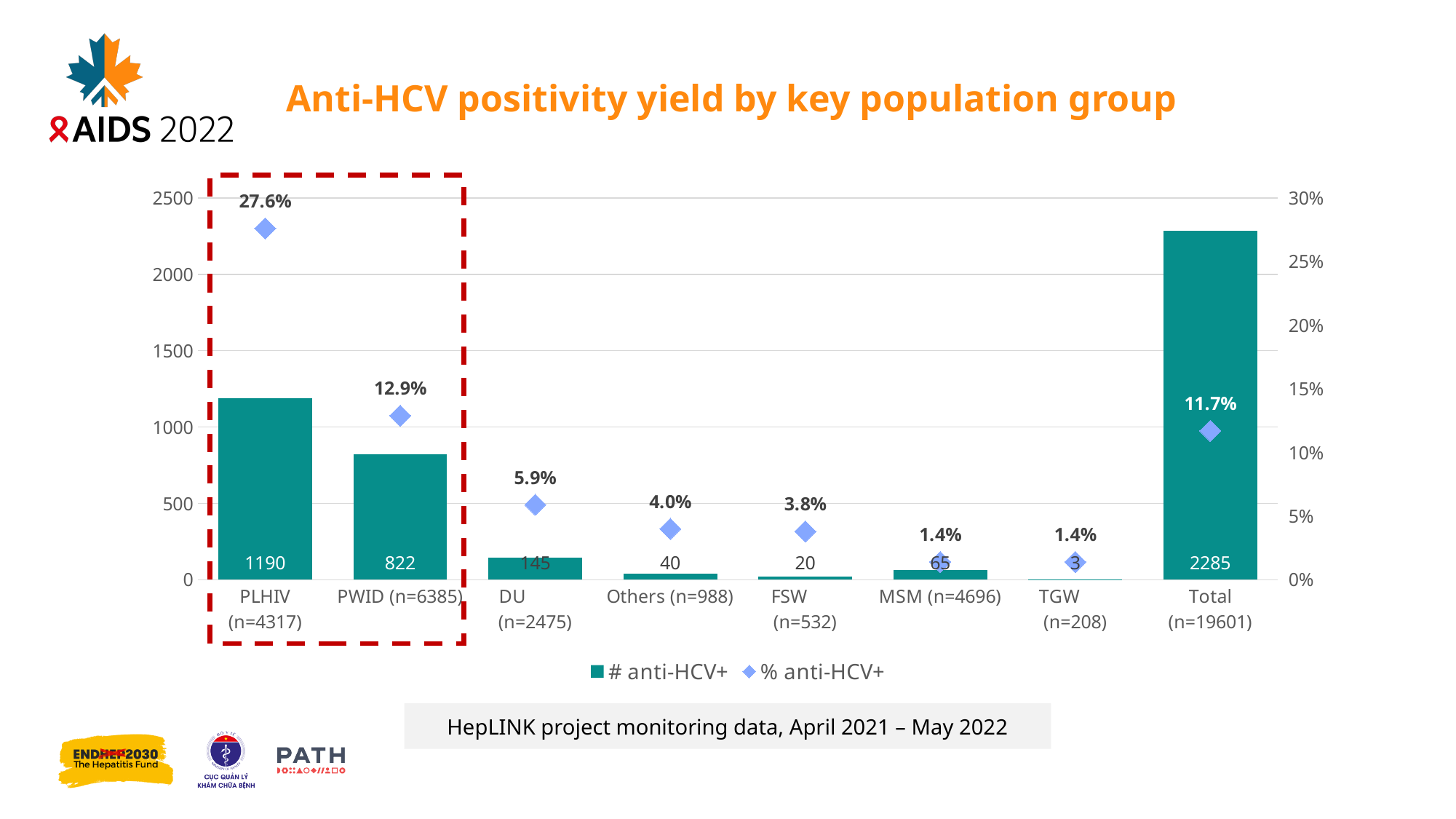
How many population groups (including Total) are shown on the x axis? 8 What is the % anti-HCV+ value for the Total group? 11.7% What is the number of anti-HCV+ cases (# anti-HCV+) for PLHIV? 1190 What is the # anti-HCV+ value for DU? 145 Which group has the highest % anti-HCV+? PLHIV What is the % anti-HCV+ value for PWID? 12.9% What kind of chart is used to show the # anti-HCV+ series? bar chart What is the difference in # anti-HCV+ between PLHIV and PWID? 368 How many series does the legend list? 2 Excluding the Total bar, which key population group has the highest # anti-HCV+? PLHIV Which group has the lowest # anti-HCV+? TGW Which has a higher % anti-HCV+, DU or FSW? DU